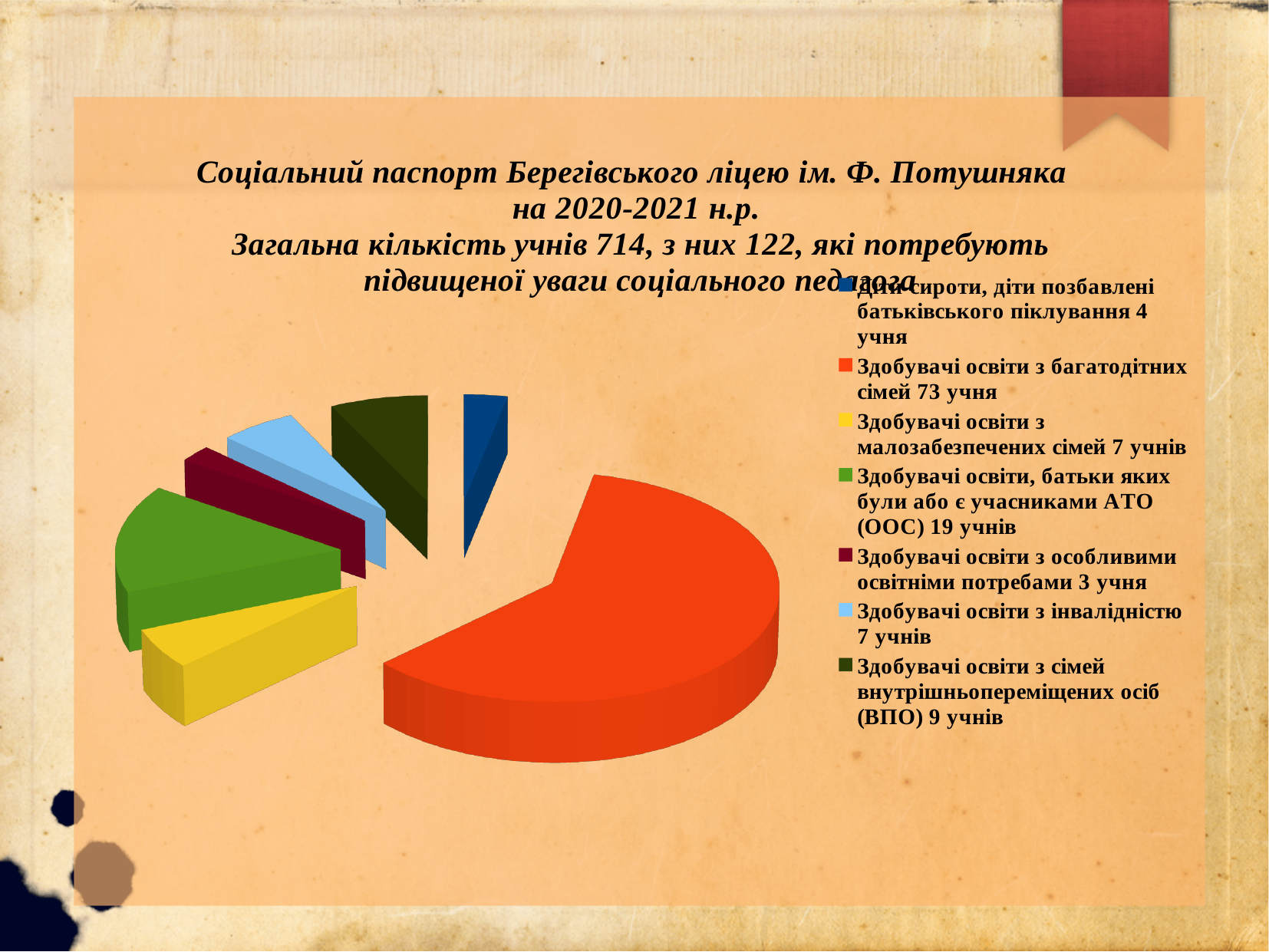
Which category has the largest slice of the pie chart? Здобувачі освіти з багатодітних сімей (73 учня) Which is larger: the number of students from families of internally displaced persons (ВПО) or the number from low-income families (малозабезпечених сімей)? Здобувачі освіти з сімей ВПО (9 учнів) What colour is the largest slice of the pie chart? Orange-red Which category has the smallest slice of the pie chart? Здобувачі освіти з особливими освітніми потребами (3 учня) What kind of chart is shown on the slide? Pie chart How many students are in the category 'Здобувачі освіти з сімей внутрішньопереміщених осіб (ВПО)'? 9 учнів How many categories does the pie chart show? 7 What is the total number of students across all categories in the pie chart? 122 How many students are in the category 'Здобувачі освіти, батьки яких були або є учасниками АТО (ООС)'? 19 учнів How many students are in the category 'Діти-сироти, діти позбавлені батьківського піклування'? 4 учня What is the difference between the number of students from large families (багатодітних сімей) and the number whose parents were or are ATO (OOC) participants? 54 What is the difference between the number of students whose parents were or are ATO (OOC) participants and the number from families of internally displaced persons (ВПО)? 10